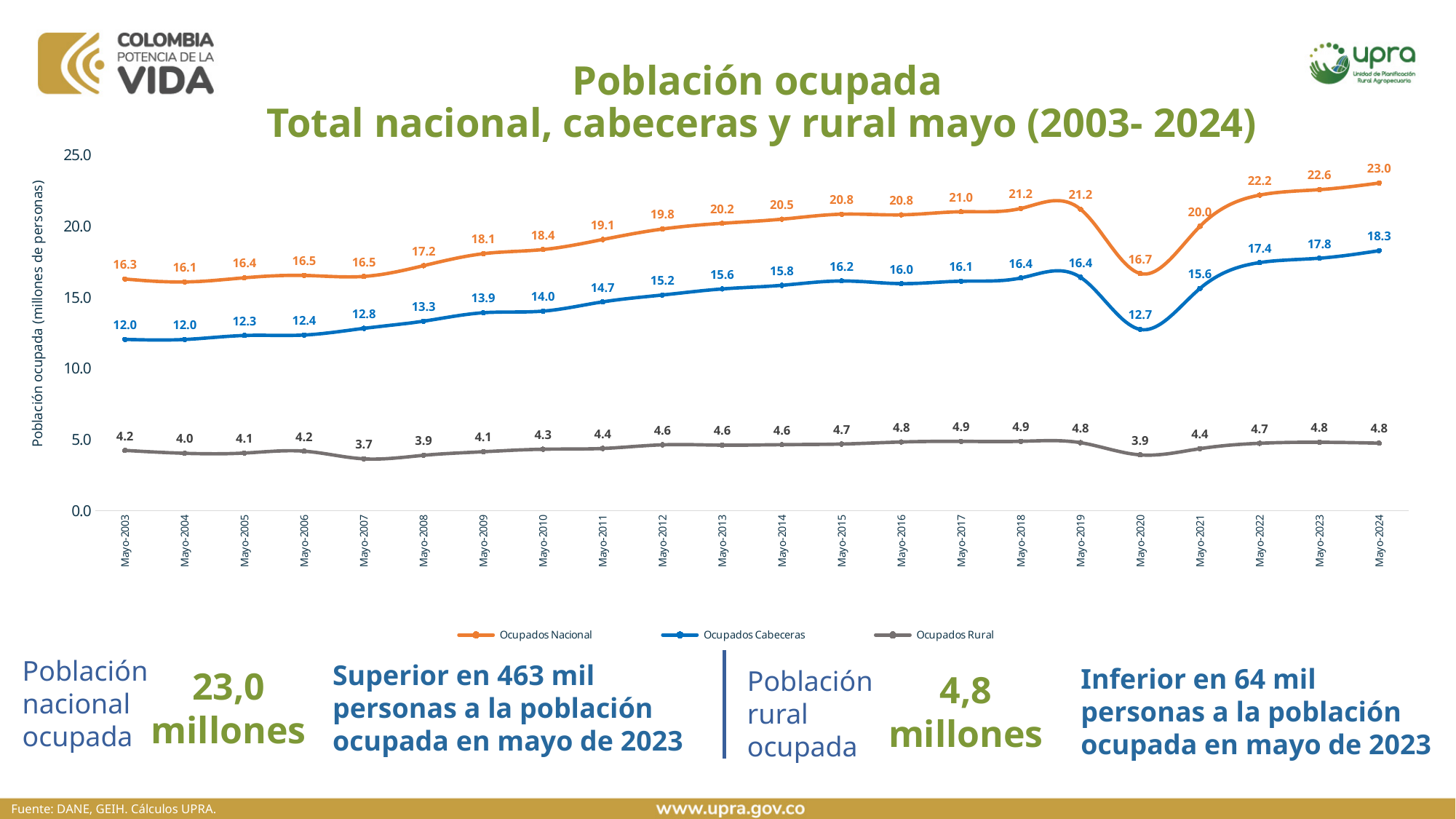
What kind of chart is shown on the slide? Line chart In which period does Ocupados Nacional reach its lowest value? Mayo-2004 What is the value of Ocupados Rural for Mayo-2007? 3.7 Does Ocupados Nacional rise or fall from Mayo-2020 to Mayo-2024? Rise What is the value of Ocupados Cabeceras for Mayo-2020? 12.7 How many time points are plotted for each series? 22 What is the difference between Ocupados Nacional in Mayo-2024 and Mayo-2023? 0.4 Which is larger for Ocupados Cabeceras: Mayo-2019 or Mayo-2021? Mayo-2019 In which period does Ocupados Nacional reach its highest value? Mayo-2024 How many series does the legend list? 3 In which period does Ocupados Rural reach its lowest value? Mayo-2007 What is the value of Ocupados Nacional for Mayo-2024? 23.0